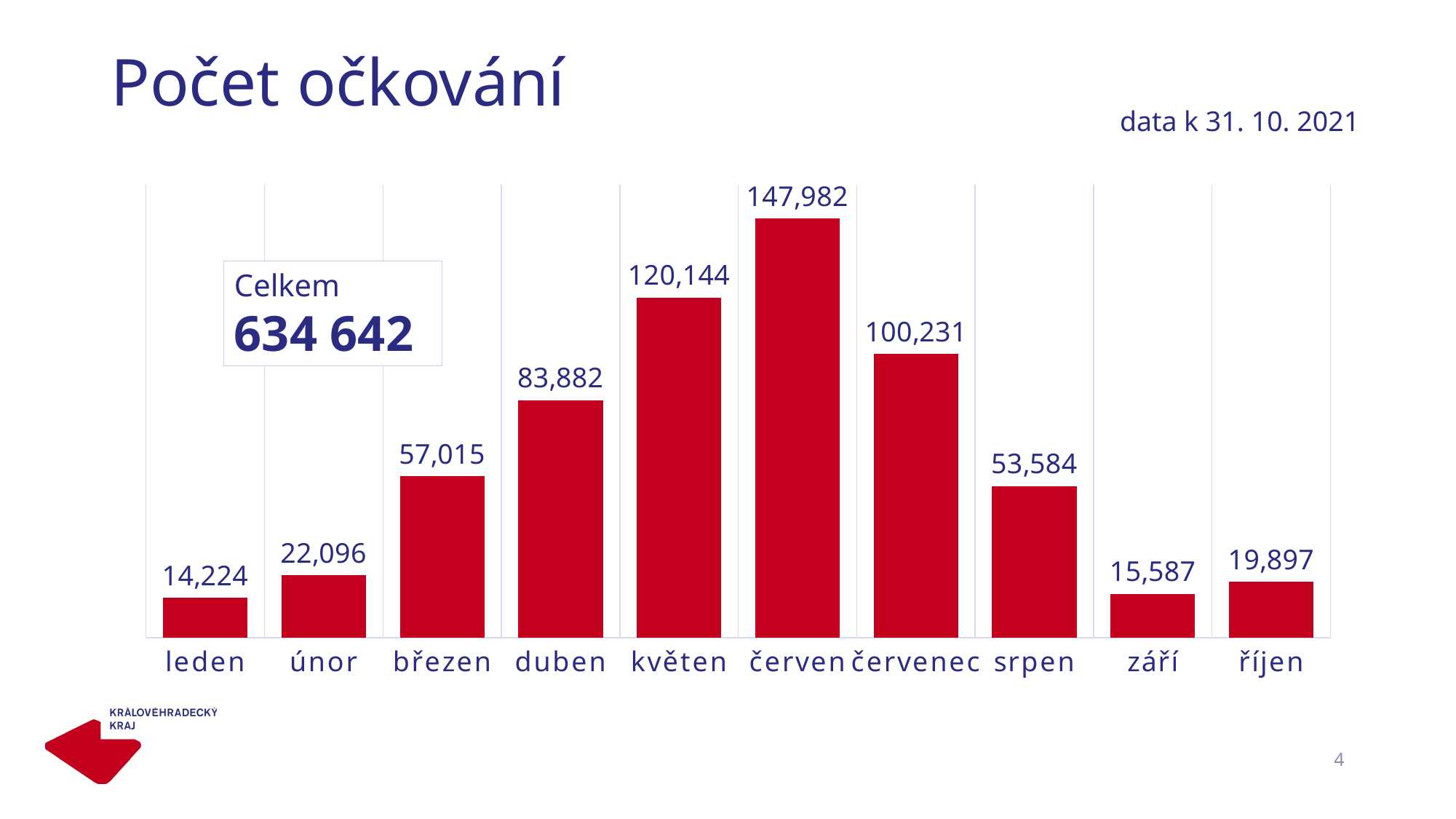
Which is larger, the value for únor or the value for říjen? únor What is the value for září? 15,587 How many months are shown on the x axis? 10 Which month has the highest value? červen Which month has the lowest value? leden Do the values rise or fall from červen to září? fall What is the difference between the values for duben and srpen? 30,298 What is the value for březen? 57,015 What is the difference between the values for červen and květen? 27,838 What is the value for červen? 147,982 What kind of chart is shown on the slide? bar chart What total (Celkem) is shown in the box on the chart? 634 642